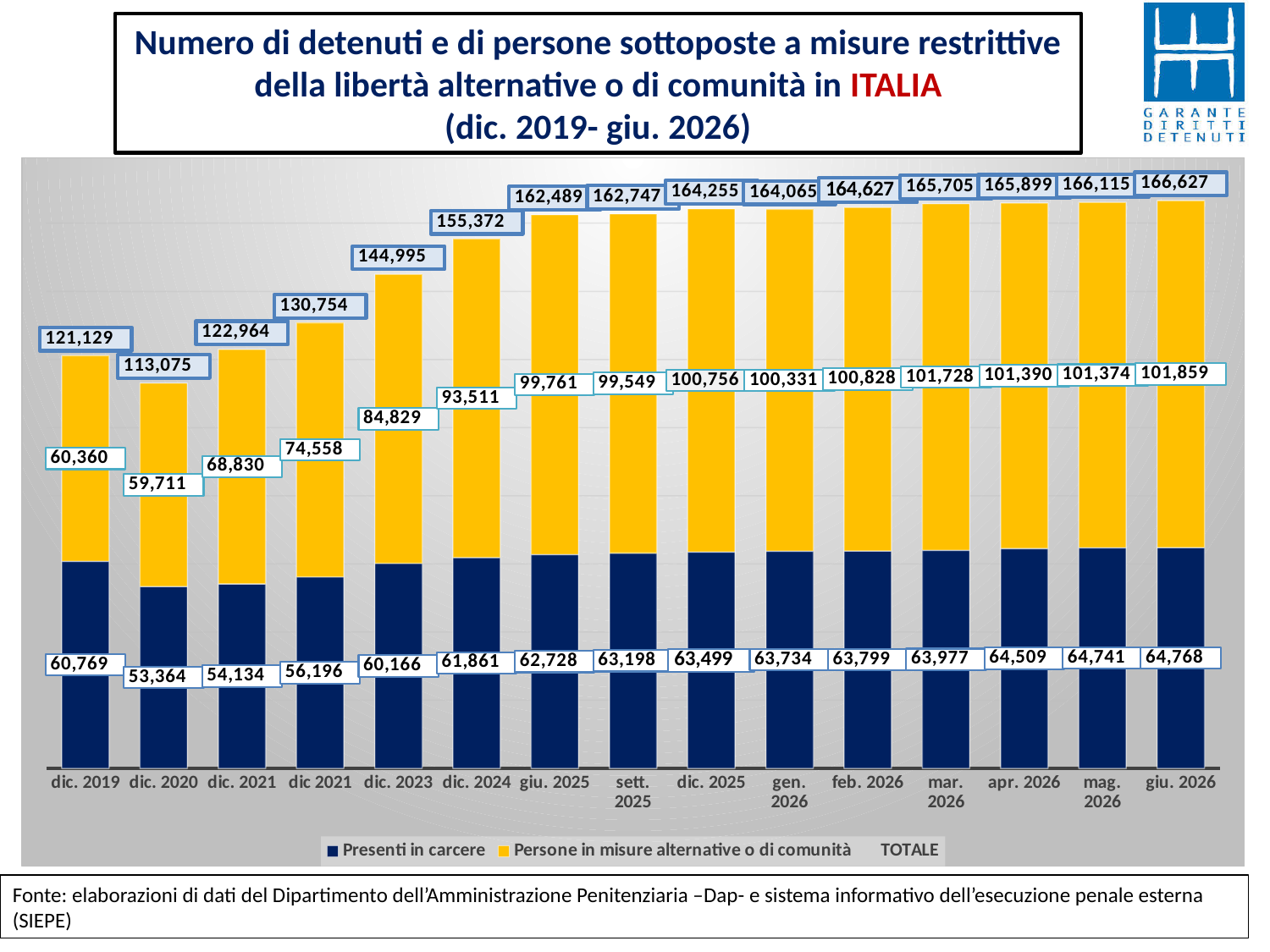
What type of chart is shown on the slide? stacked bar chart Does the TOTALE value generally rise or fall from dic. 2020 to giu. 2026? rise What is the value of 'Persone in misure alternative o di comunità' for giu. 2026? 101,859 What is the value of 'Presenti in carcere' for dic. 2019? 60,769 What is the TOTALE value for dic. 2024? 155,372 Which period has the lowest TOTALE value? dic. 2020 How many time periods (bars) are shown on the x axis? 15 Which is larger for dic. 2023: 'Presenti in carcere' or 'Persone in misure alternative o di comunità'? Persone in misure alternative o di comunità How many series does the legend list? 3 Which period has the highest TOTALE value? giu. 2026 What is the difference between the 'Presenti in carcere' values for giu. 2026 and dic. 2020? 11,404 Which colour represents 'Presenti in carcere' in the chart? dark blue